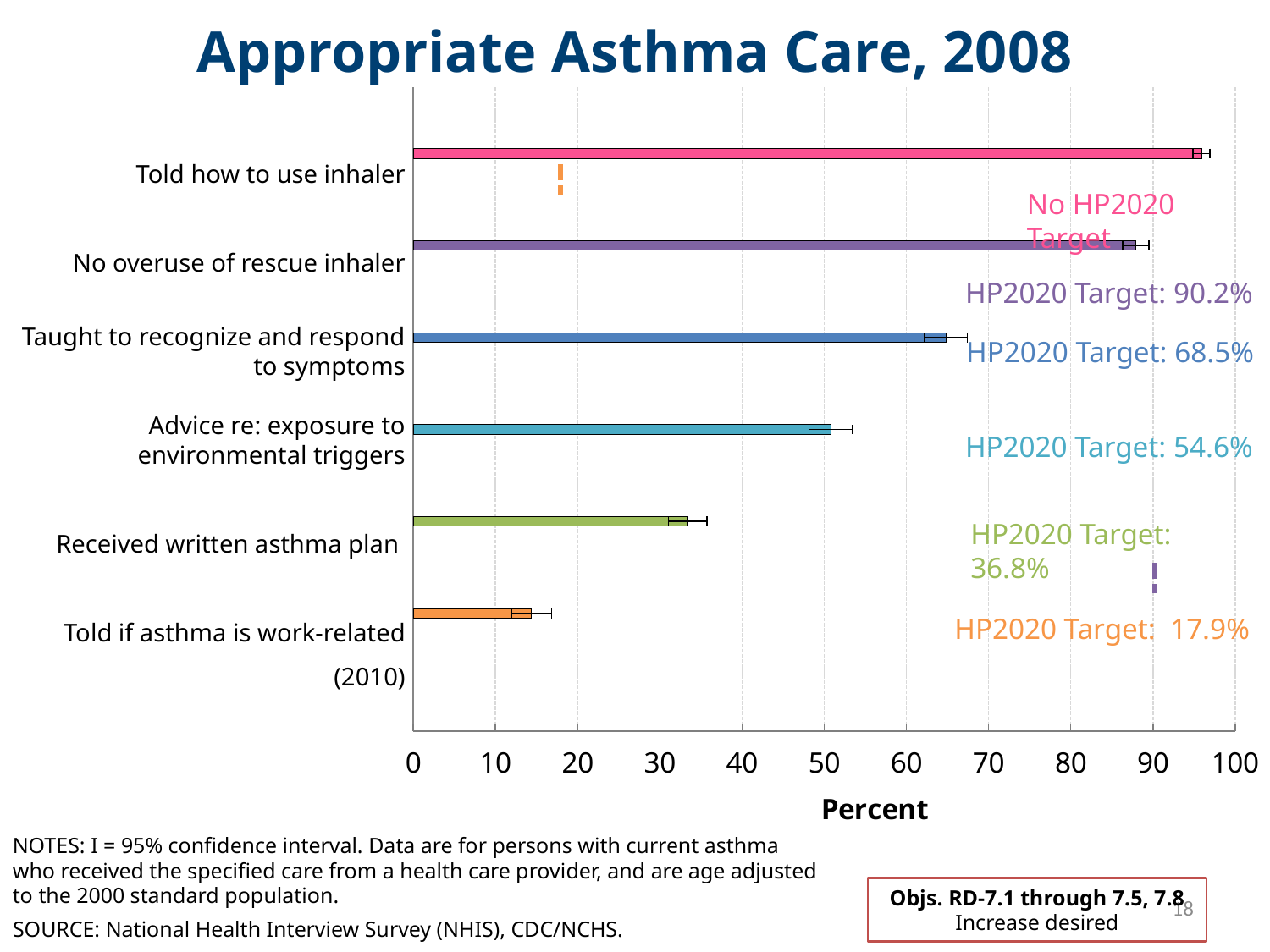
Is the value for 'Advice re: exposure to environmental triggers' greater or less than 40? greater Is the value for 'Told how to use inhaler' greater or less than 90? greater Which category has the highest percentage? Told how to use inhaler What is the HP2020 Target shown for 'Received written asthma plan'? 36.8% What kind of chart is shown on the slide? bar chart Which is larger: the value for 'No overuse of rescue inhaler' or the value for 'Taught to recognize and respond to symptoms'? No overuse of rescue inhaler Which category has the lowest percentage? Told if asthma is work-related (2010) Is the value for 'Told if asthma is work-related (2010)' greater or less than 20? less What is the label on the x axis of the chart? Percent What is the HP2020 Target shown for 'Taught to recognize and respond to symptoms'? 68.5% How many categories of asthma care are plotted on the chart? 6